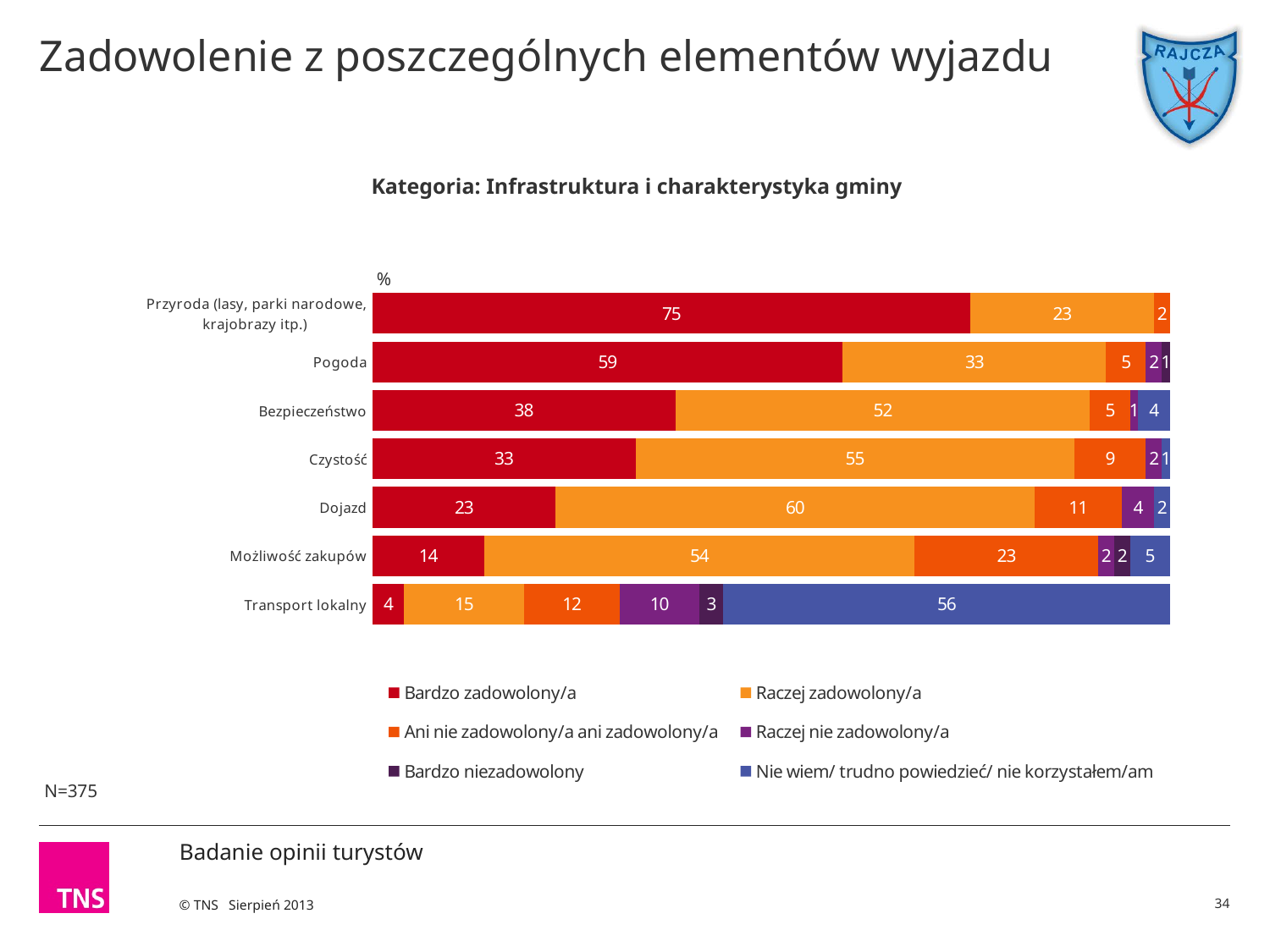
What percentage of respondents were 'Bardzo zadowolony/a' with Przyroda (lasy, parki narodowe, krajobrazy itp.)? 75 Which category has the highest 'Bardzo zadowolony/a' value? Przyroda (lasy, parki narodowe, krajobrazy itp.) How many series does the legend list? 6 How many categories are shown on the chart? 7 Which is larger: the 'Raczej zadowolony/a' value for Czystość or for Bezpieczeństwo? Czystość What is the 'Raczej zadowolony/a' value for Dojazd? 60 Which category has the lowest 'Bardzo zadowolony/a' value? Transport lokalny What is the 'Nie wiem/ trudno powiedzieć/ nie korzystałem/am' value for Transport lokalny? 56 What is the 'Ani nie zadowolony/a ani zadowolony/a' value for Możliwość zakupów? 23 What is the difference between the 'Bardzo zadowolony/a' values for Pogoda and Bezpieczeństwo? 21 What kind of chart is shown on the slide? Stacked bar chart What is the sample size (N) stated on the slide? N=375